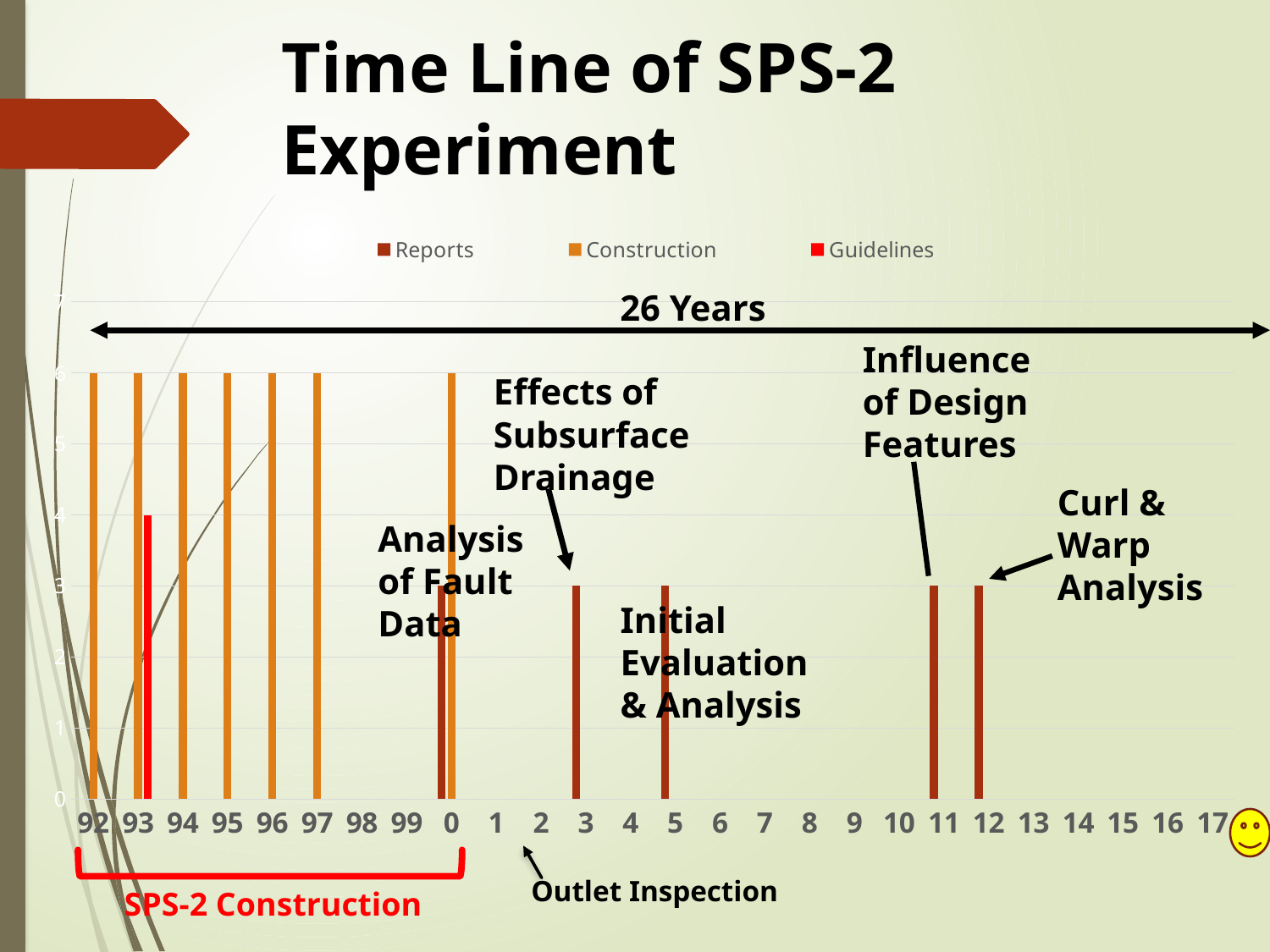
How many series does the legend list? 3 Which series is shown in bright red in the legend? Guidelines At 93, which is larger: the Construction bar or the Guidelines bar? Construction What kind of chart is shown on the slide? bar chart How many Reports bars are plotted on the chart? 5 Is the Guidelines value at 93 greater or less than 5? less Is the Construction value at 92 greater or less than 5? greater Is the Reports value at 5 greater or less than 4? less What are the three legend entries of the chart? Reports, Construction, Guidelines How many Construction bars are plotted on the chart? 7 What value does the Reports bar at 11 reach on the y axis? 3 Which is larger: the Reports bar at 3 or the Construction bar at 0? Construction bar at 0